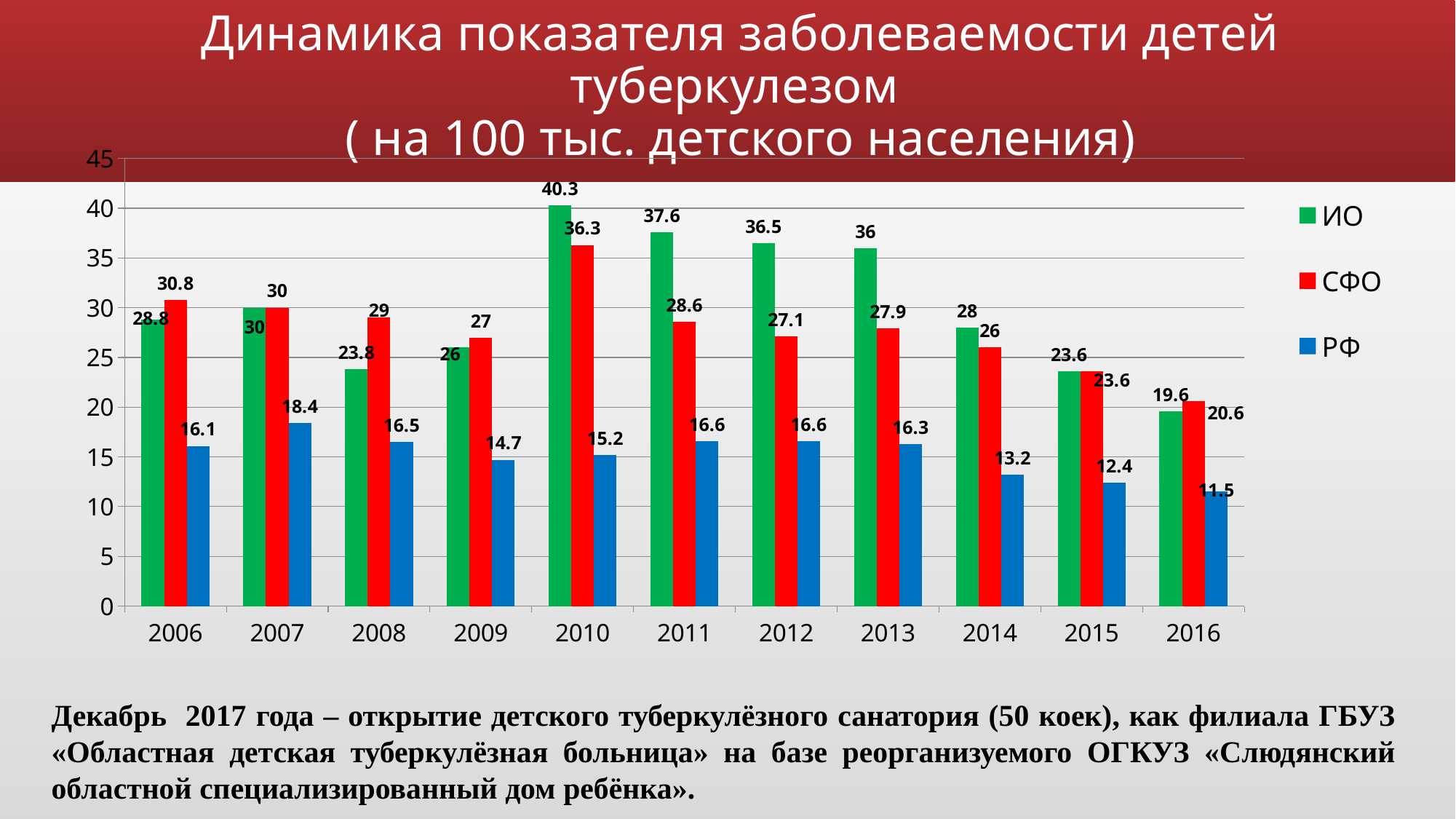
How many years are shown on the x axis? 11 In which year is the РФ value lowest? 2016 What is the difference between the ИО and СФО values in 2011? 9 Which colour represents the РФ series? blue What is the value for ИО in 2010? 40.3 Is the value for ИО in 2013 greater or less than 30? greater Which is larger in 2006, the ИО value or the СФО value? СФО In which year is the ИО value highest? 2010 How many series does the legend list? 3 What is the value for СФО in 2008? 29 What kind of chart is shown on the slide? bar chart What is the value for РФ in 2016? 11.5